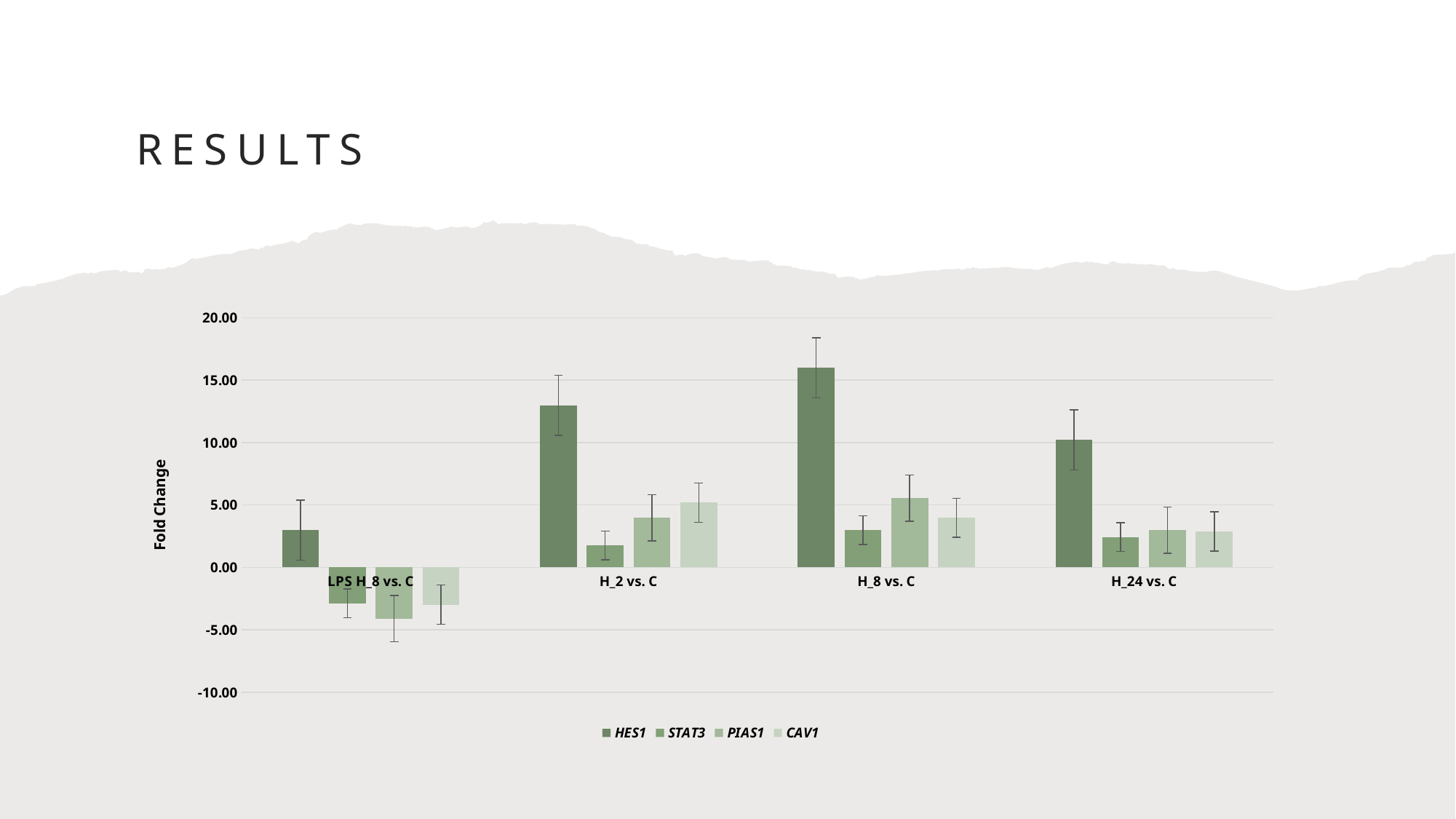
Which is larger: HES1 in H_8 vs. C or HES1 in H_24 vs. C? HES1 in H_8 vs. C Is the value for STAT3 in LPS H_8 vs. C greater or less than 0.00? less In which category does HES1 reach its highest value? H_8 vs. C Which series has the highest value in the H_2 vs. C category? HES1 How many categories are shown on the x axis of the chart? 4 Which bar has the lowest value in the whole chart? PIAS1 in LPS H_8 vs. C Is the value for HES1 in H_2 vs. C greater or less than 10.00? greater What is the title of the vertical axis? Fold Change Is the value for HES1 in H_8 vs. C greater or less than 15.00? greater What kind of chart is shown on the slide? bar chart Which series are listed in the legend? HES1, STAT3, PIAS1, CAV1 How many series does the chart's legend list? 4